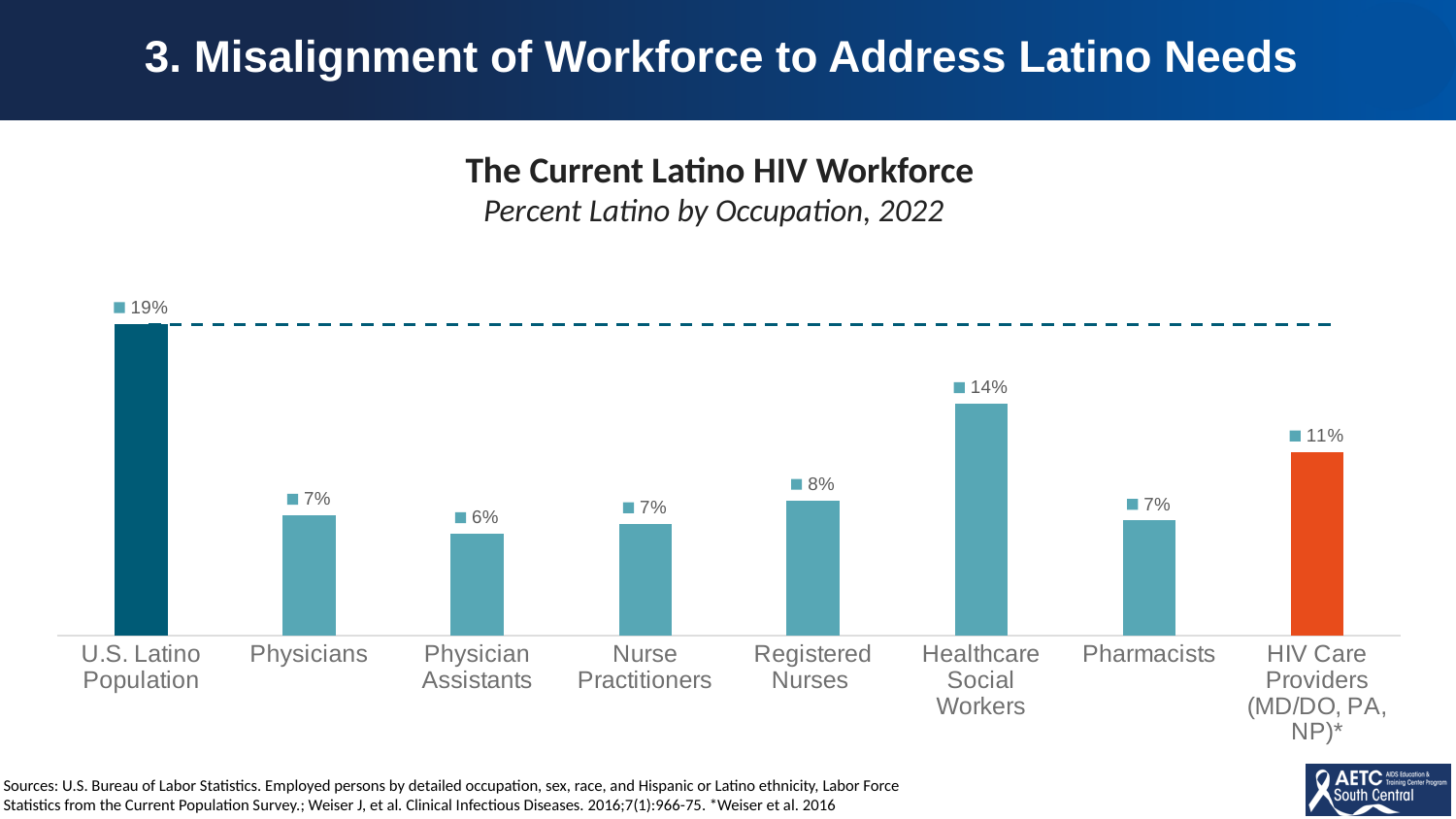
Which category has the lowest value? Physician Assistants What is the value for Healthcare Social Workers? 14% What is the value for Physician Assistants? 6% What is the value for Registered Nurses? 8% How many categories are shown on the chart? 8 What kind of chart is shown on the slide? Bar chart What is the difference between the U.S. Latino Population value and the Healthcare Social Workers value? 5% What is the subtitle of the chart? Percent Latino by Occupation, 2022 Which is larger, the value for Healthcare Social Workers or the value for HIV Care Providers (MD/DO, PA, NP)*? Healthcare Social Workers What is the value for U.S. Latino Population? 19% Which category has the highest value? U.S. Latino Population What is the value for HIV Care Providers (MD/DO, PA, NP)*? 11%